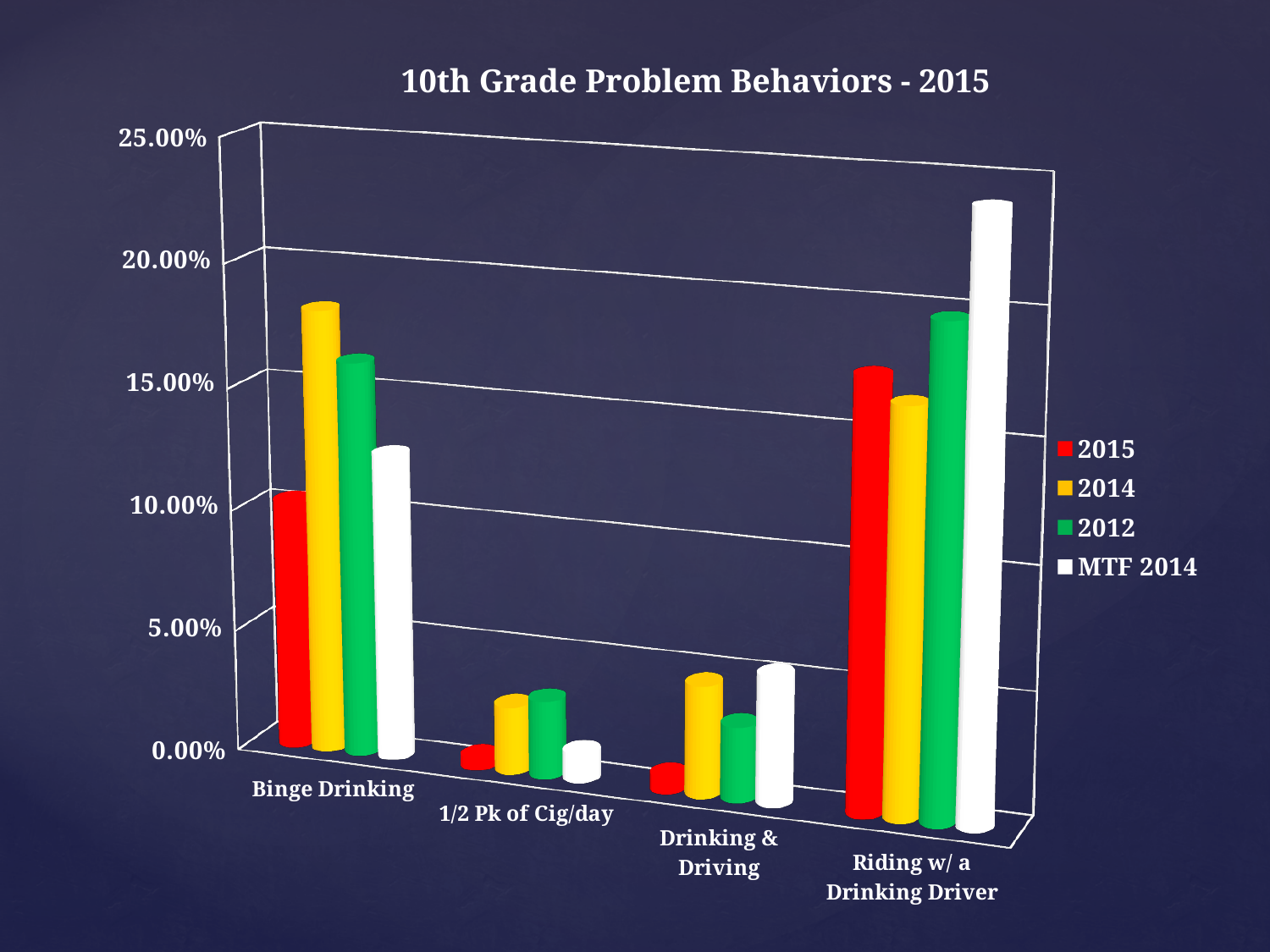
What is the title of the chart? 10th Grade Problem Behaviors - 2015 For Riding w/ a Drinking Driver, which is larger: the 2012 value or the 2014 value? 2012 Which series has the highest value for Riding w/ a Drinking Driver? MTF 2014 For Binge Drinking, which is larger: the 2014 value or the 2012 value? 2014 Which series has the highest value for Binge Drinking? 2014 Is the 2015 value for Binge Drinking greater or less than 15.00%? less Is the MTF 2014 value for Riding w/ a Drinking Driver greater or less than 20.00%? greater Is the 2014 value for Binge Drinking greater or less than 15.00%? greater How many series does the legend list? 4 Which series has the lowest value for Binge Drinking? 2015 What kind of chart is shown on the slide? Bar chart How many behavior categories are shown on the x axis? 4